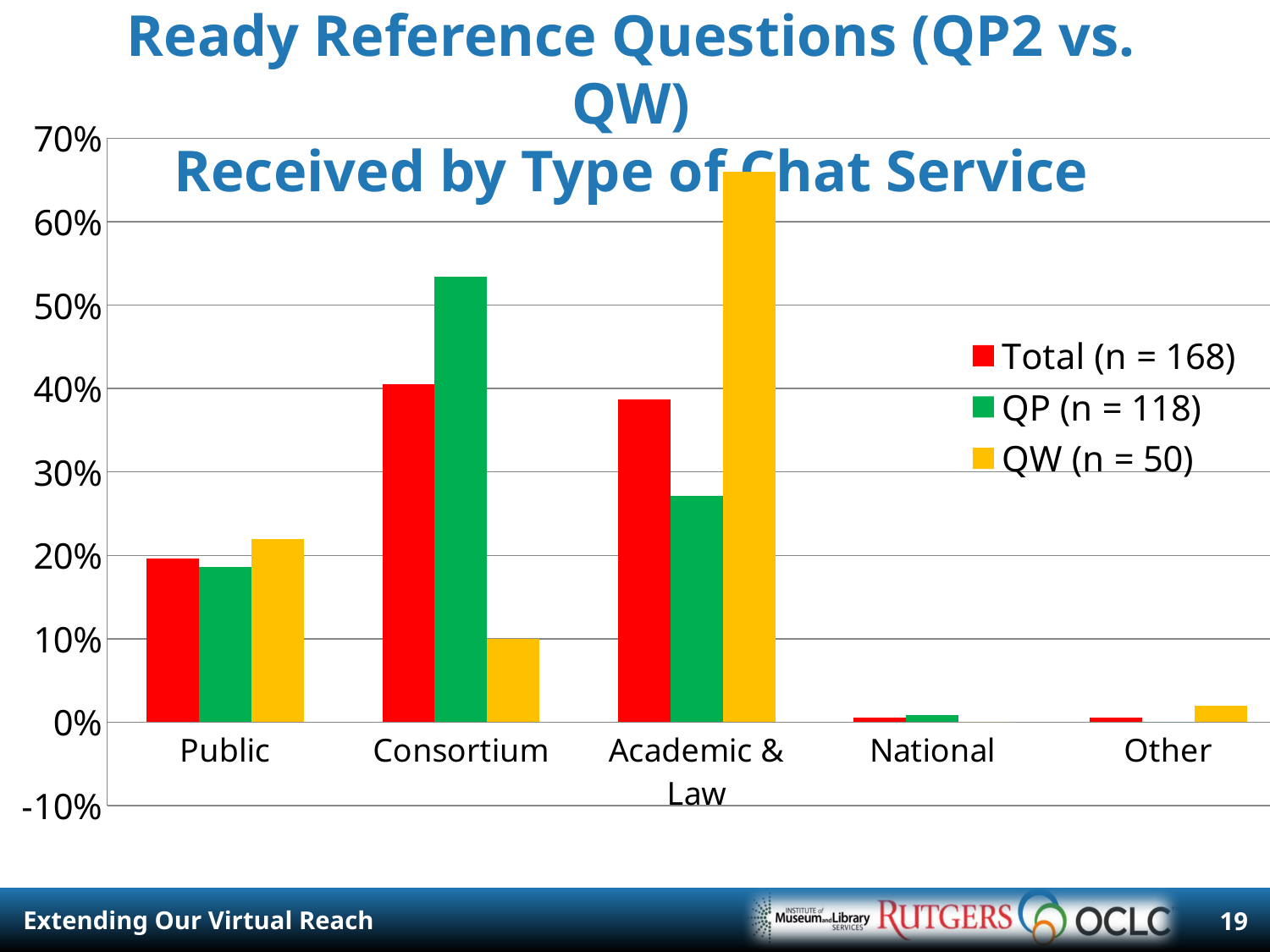
What kind of chart is shown on the slide? bar chart For Academic & Law, which is larger: the Total (n = 168) value or the QP (n = 118) value? Total (n = 168) How many series does the legend list? 3 How many categories are shown on the x axis? 5 Is the QW (n = 50) value for Academic & Law greater or less than 60%? greater What colour represents the QW (n = 50) series? yellow For Consortium, which is larger: the QP (n = 118) value or the QW (n = 50) value? QP (n = 118) Which category has the highest QP (n = 118) value? Consortium Which category has the highest Total (n = 168) value? Consortium Which category has the highest QW (n = 50) value? Academic & Law Is the QP (n = 118) value for Consortium greater or less than 50%? greater